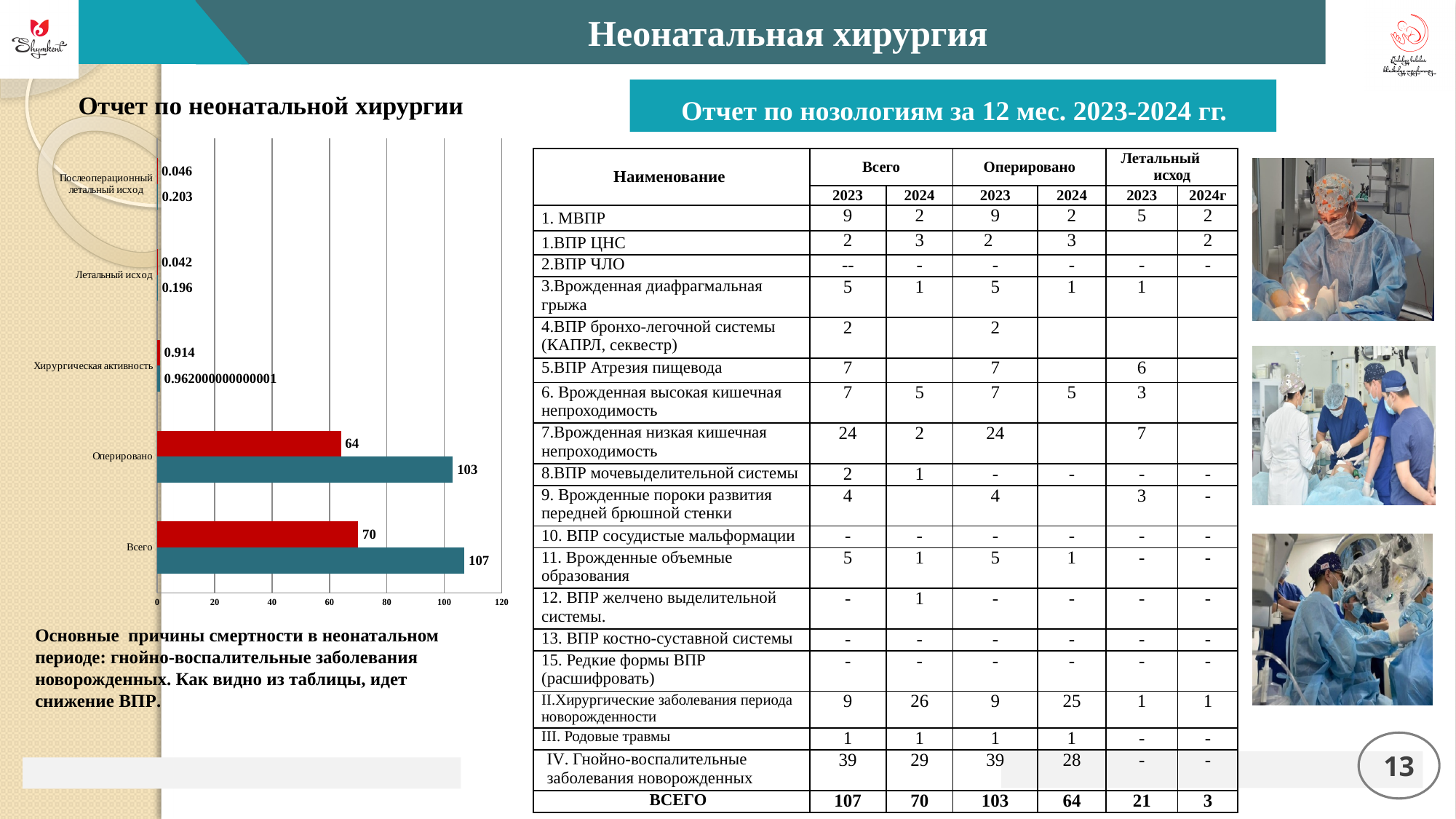
What is the value of the red bar for "Всего" in the bar chart? 70 What is the title of the bar chart on the left of the slide? Отчет по неонатальной хирургии What kind of chart is shown under the title "Отчет по неонатальной хирургии"? bar chart What is the value of the teal bar for "Летальный исход" in the bar chart? 0.196 Which category has the longest teal bar in the bar chart? Всего What is the value of the teal bar for "Оперировано" in the bar chart? 103 What is the value of the red bar for "Послеоперационный летальный исход" in the bar chart? 0.046 In the bar chart, what is the difference between the teal and red bars for "Оперировано"? 39 In the bar chart, which red bar is larger: "Всего" or "Оперировано"? Всего In the bar chart, what is the difference between the teal and red bars for "Всего"? 37 What is the value of the red bar for "Хирургическая активность" in the bar chart? 0.914 How many categories are shown on the vertical axis of the bar chart? 5